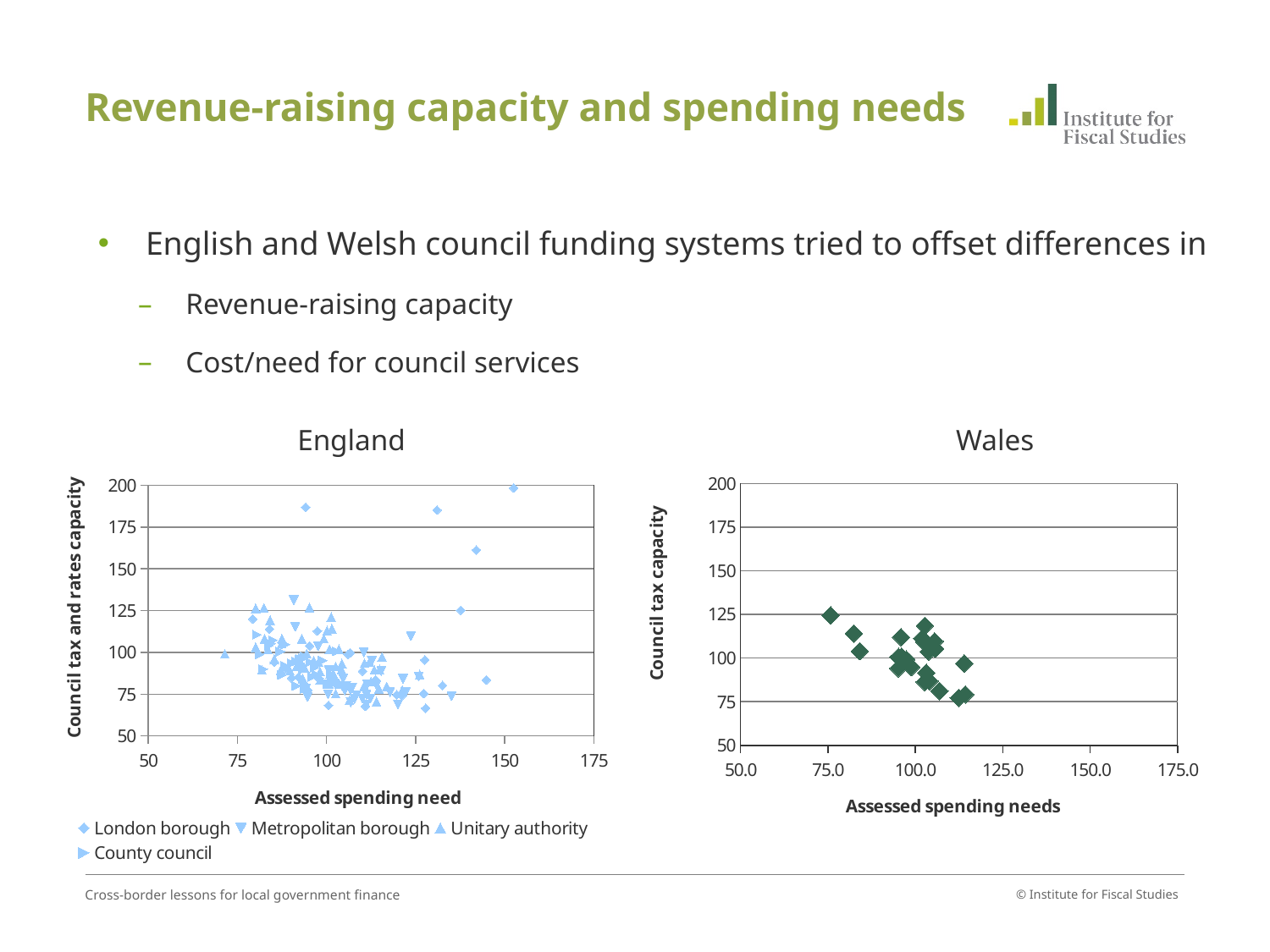
In the England chart, is the lowest council tax and rates capacity value plotted greater or less than 75? less How many series does the legend of the England chart list? 4 In the England chart, which series does the point with the highest council tax and rates capacity belong to? London borough In the England chart, which series is shown with a downward-pointing triangle marker? Metropolitan borough In the England chart, is the highest council tax and rates capacity value plotted greater or less than 175? greater In the Wales chart, do the values of council tax capacity generally rise or fall as assessed spending needs increase? Fall What is the maximum value shown on the vertical axis of the Wales chart? 200 What is the title of the vertical axis on the Wales chart? Council tax capacity What kind of chart is the England chart? Scatter chart In the Wales chart, is the council tax capacity of the point with the lowest assessed spending needs (around 75) greater or less than 100? greater What kind of chart is the Wales chart? Scatter chart